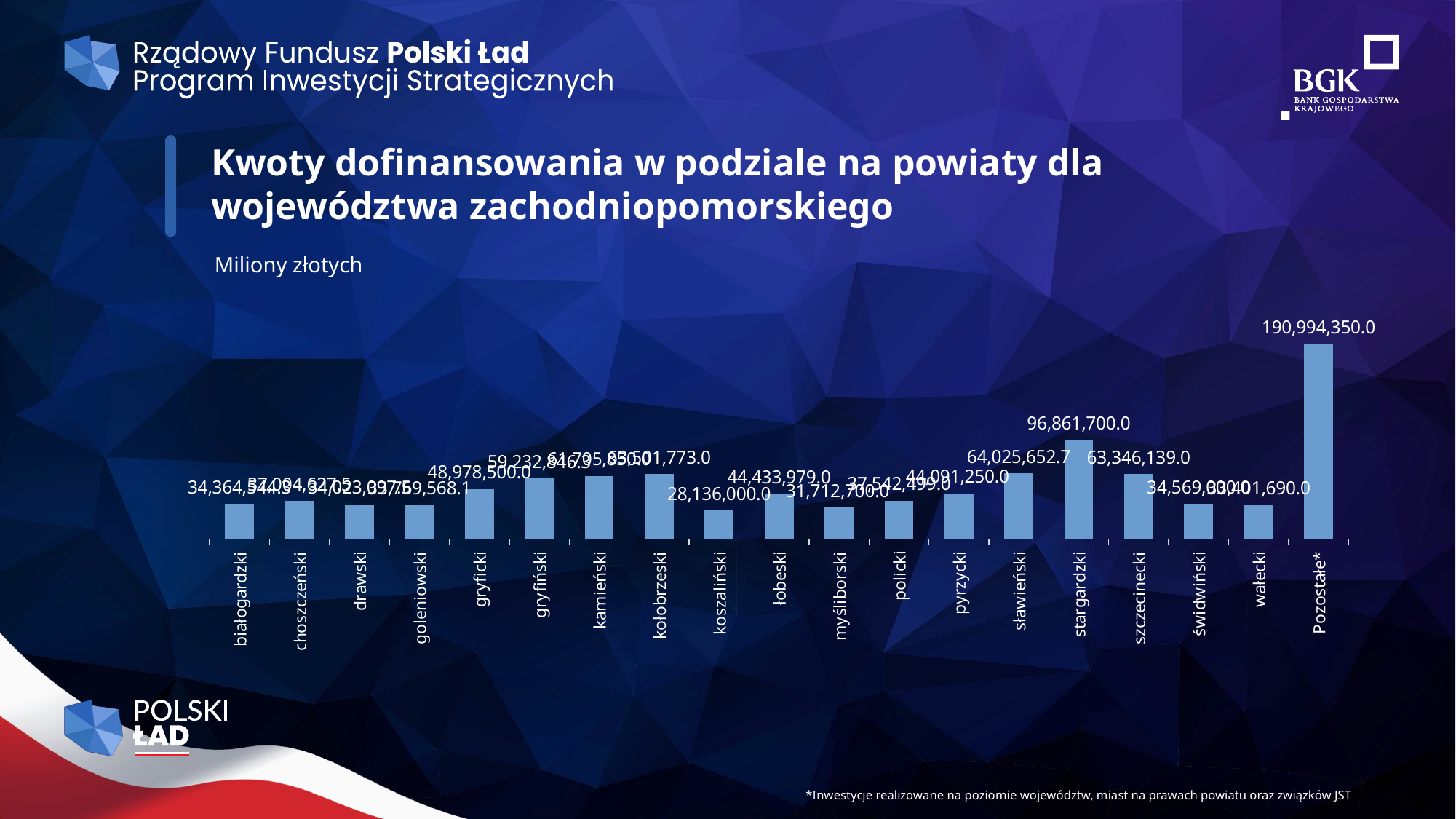
Which category has the highest value in the chart? Pozostałe* How many categories (bars) are shown in the chart? 19 What is the value for koszaliński? 28,136,000.0 What is the value for Pozostałe*? 190,994,350.0 Which category has the lowest value in the chart? koszaliński What unit label is shown above the chart? Miliony złotych What is the value for sławieński? 64,025,652.7 What is the value for stargardzki? 96,861,700.0 What type of chart is shown on the slide? bar chart Which is larger, the value for stargardzki or the value for szczecinecki? stargardzki What is the value for gryficki? 48,978,500.0 What is the difference between the values for stargardzki and szczecinecki? 33,515,561.0